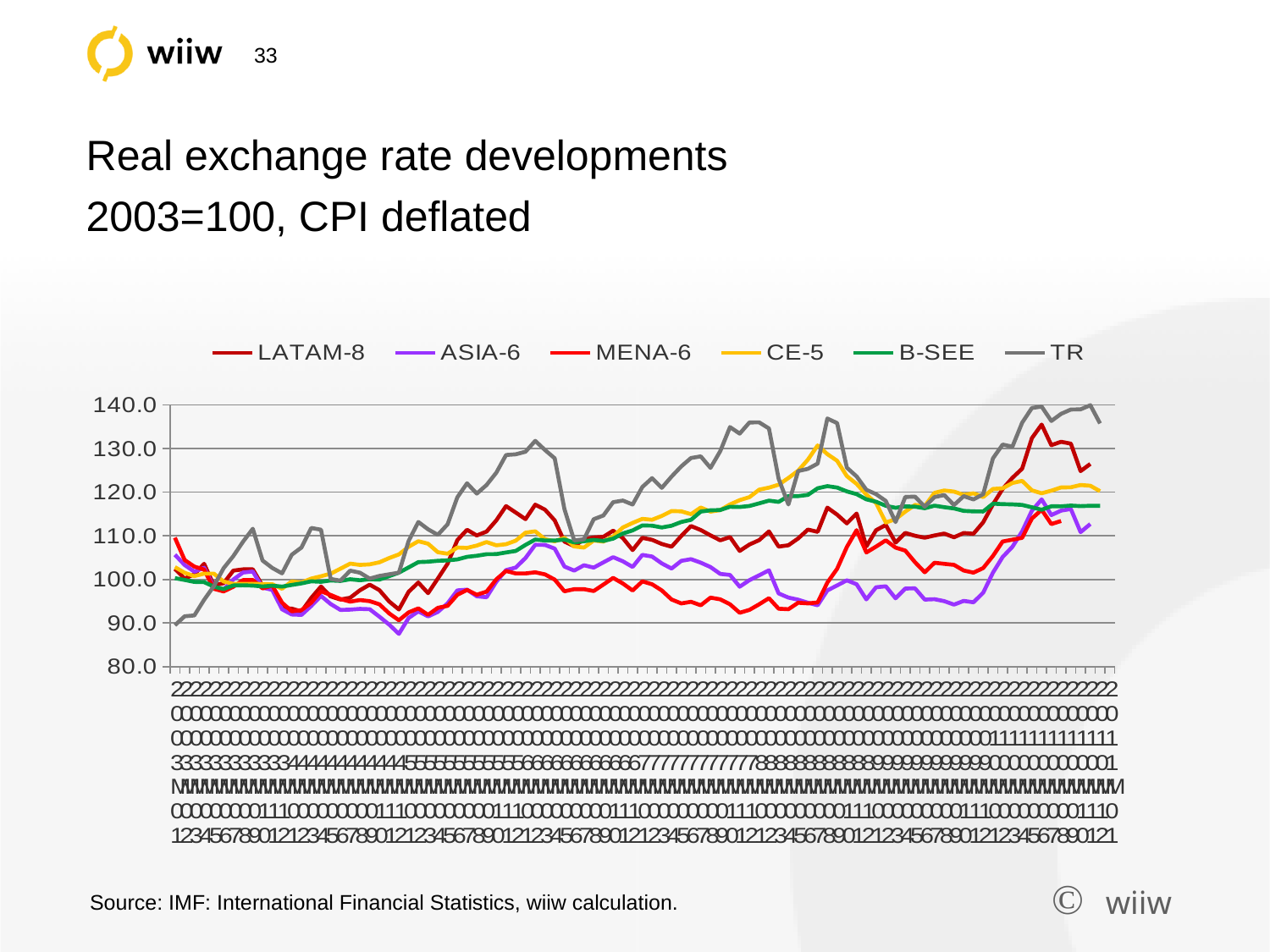
What kind of chart is shown on the slide? line chart Is the value of TR at the right-hand end of the chart greater or less than 130? greater At the right-hand end of the chart, which is larger: LATAM-8 or ASIA-6? LATAM-8 Does the B-SEE series rise or fall overall from the left to the right of the chart? rise Is the value of B-SEE at the right-hand end of the chart greater or less than 120? less Which series has the highest value at the right-hand end of the chart? TR Which series reaches the highest value anywhere on the chart? TR Is the lowest value reached by ASIA-6 greater or less than 90? less How many series does the legend list? 6 At the right-hand end of the chart, which is larger: TR or B-SEE? TR What colour is the TR line in the chart? grey What is the highest value shown on the vertical axis? 140.0